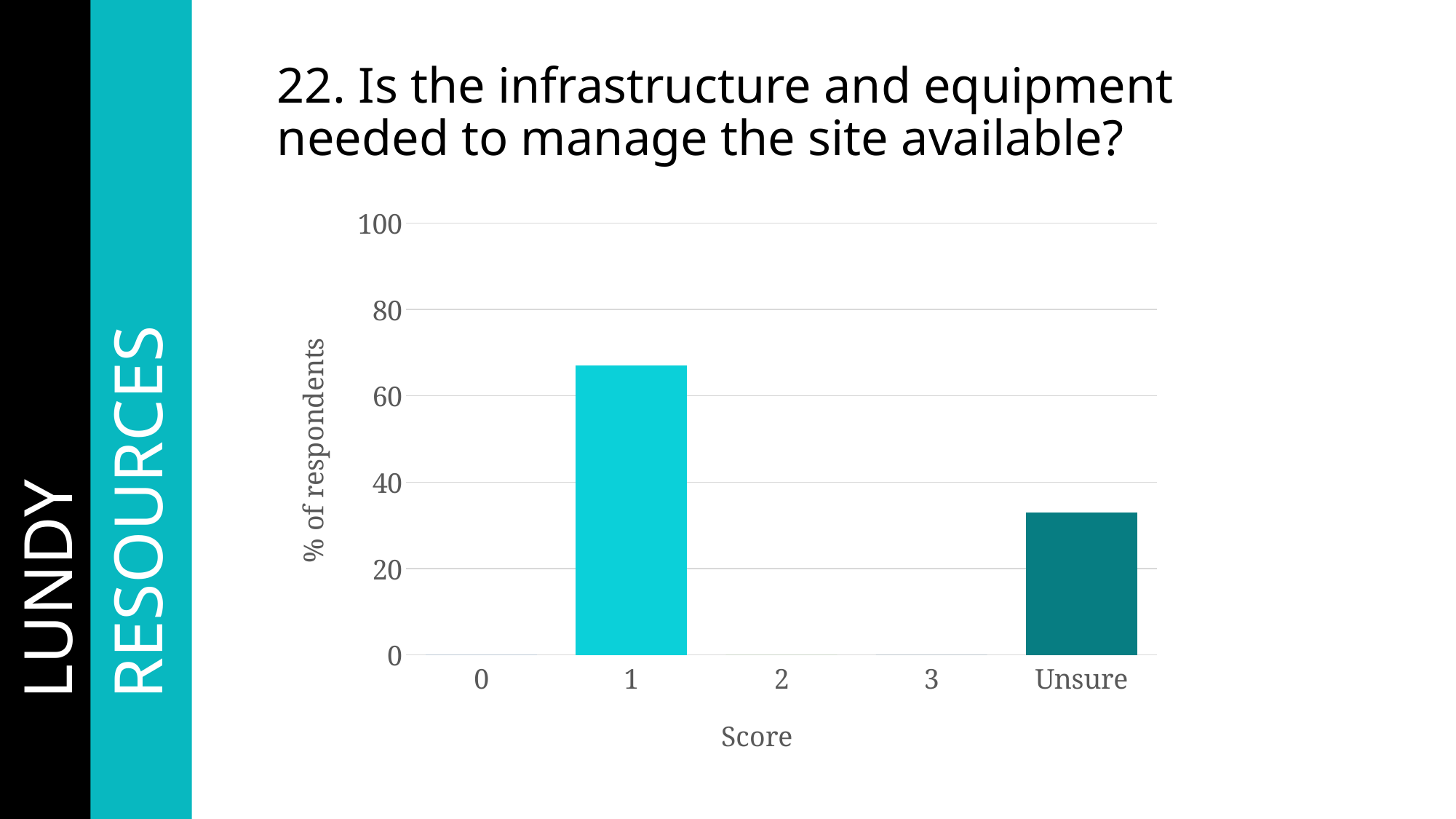
Is the value for score 1 greater or less than 60? greater Which is larger, the value for score 0 or the value for Unsure? Unsure Which score category has the highest percentage of respondents? 1 Is the value for Unsure greater or less than 40? less What is the label of the x axis? Score Is the value for score 1 greater or less than 80? less What is the percentage of respondents for score 2? 0 Which is larger, the value for score 1 or the value for Unsure? score 1 What kind of chart is shown on the slide? bar chart How many categories are shown on the x axis of the chart? 5 What is the label of the y axis? % of respondents